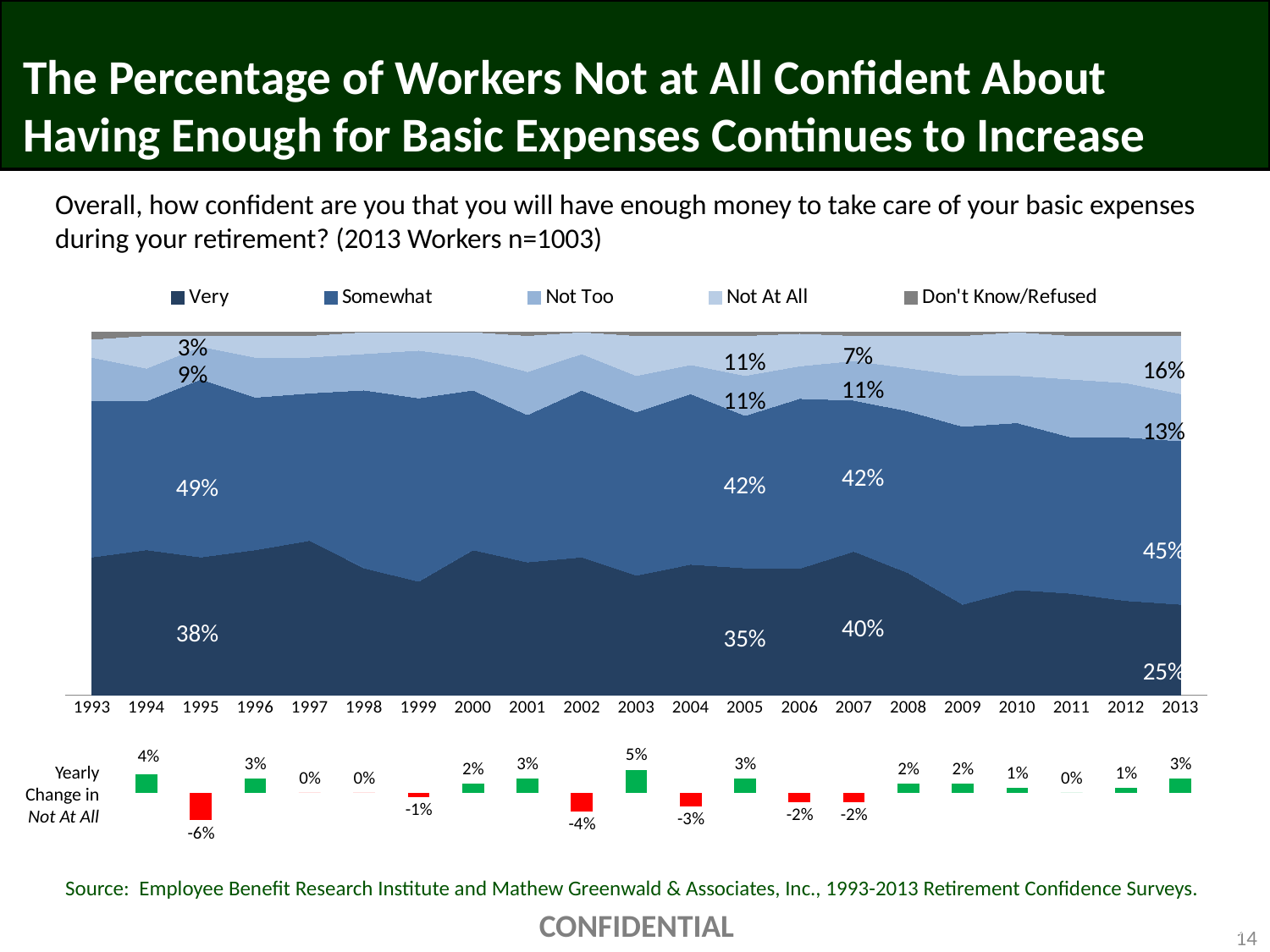
How many series does the legend of the stacked area chart list? 5 In the main chart, what is the value for Very in 2005? 35% In the main chart, what is the value for Not At All in 2013? 16% In the main chart, what is the value for Somewhat in 2007? 42% In the Yearly Change in Not At All bar chart, which year has the lowest value? 1995 What kind of chart is the main chart showing confidence levels from 1993 to 2013? Stacked area chart In the main chart, which is larger in 2013, Very or Somewhat? Somewhat How many years are shown on the x axis of the main chart? 21 In the Yearly Change in Not At All bar chart, which year has the highest value? 2003 In the main chart, what is the value for Very in 2013? 25% In the main chart, by how many percentage points did the Not At All value change from 2005 to 2013? 5 percentage points In the Yearly Change in Not At All bar chart, what is the value for 2013? 3%